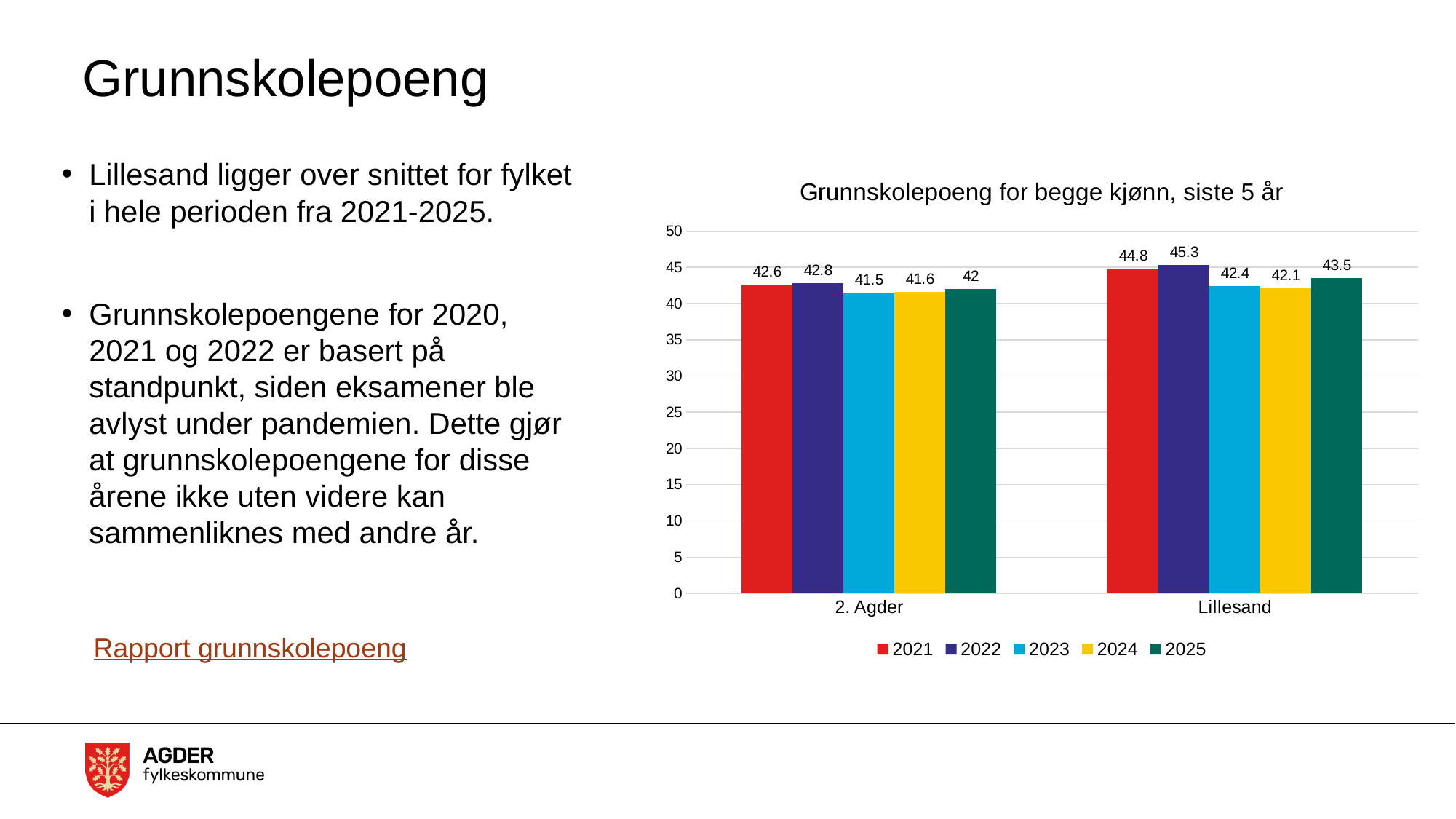
What is the difference between Lillesand and 2. Agder in 2021? 2.2 What kind of chart is shown on the slide? bar chart Which is larger, the 2024 value for Lillesand or the 2024 value for 2. Agder? Lillesand Which year has the highest value for Lillesand? 2022 What is the value for 2. Agder in 2023? 41.5 What is the value for 2. Agder in 2025? 42 How many series does the legend list? 5 Is the value for Lillesand in 2022 greater or less than 45? greater Which year has the lowest value for 2. Agder? 2023 How many categories are shown on the x axis? 2 What is the title of the chart? Grunnskolepoeng for begge kjønn, siste 5 år What is the value for Lillesand in 2022? 45.3